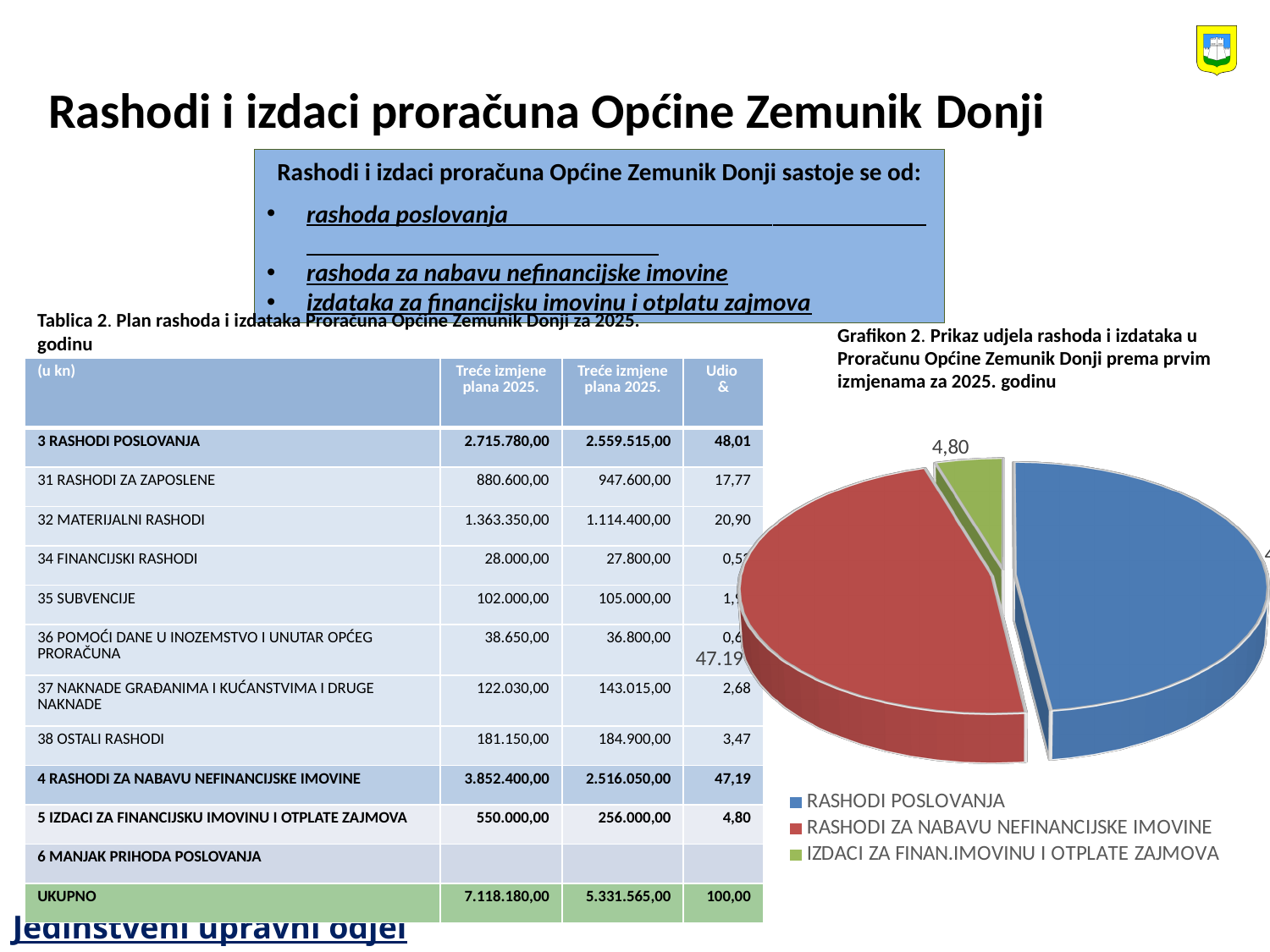
What is the caption/title given for the pie chart (Grafikon 2)? Grafikon 2. Prikaz udjela rashoda i izdataka u Proračunu Općine Zemunik Donji prema prvim izmjenama za 2025. godinu What value is labelled on the pie chart for RASHODI ZA NABAVU NEFINANCIJSKE IMOVINE? 47.19 How many slices does the pie chart have? 3 In the pie chart, which is larger: RASHODI ZA NABAVU NEFINANCIJSKE IMOVINE or IZDACI ZA FINAN.IMOVINU I OTPLATE ZAJMOVA? RASHODI ZA NABAVU NEFINANCIJSKE IMOVINE What kind of chart is shown on the slide? pie chart What colour is the RASHODI POSLOVANJA slice in the pie chart? blue How many entries does the pie chart's legend list? 3 In the pie chart, which is larger: RASHODI POSLOVANJA or IZDACI ZA FINAN.IMOVINU I OTPLATE ZAJMOVA? RASHODI POSLOVANJA Which category has the smallest slice in the pie chart? IZDACI ZA FINAN.IMOVINU I OTPLATE ZAJMOVA What value is labelled on the pie chart for IZDACI ZA FINAN.IMOVINU I OTPLATE ZAJMOVA? 4,80 What is the difference between the labelled values for RASHODI ZA NABAVU NEFINANCIJSKE IMOVINE and IZDACI ZA FINAN.IMOVINU I OTPLATE ZAJMOVA in the pie chart? 42,39